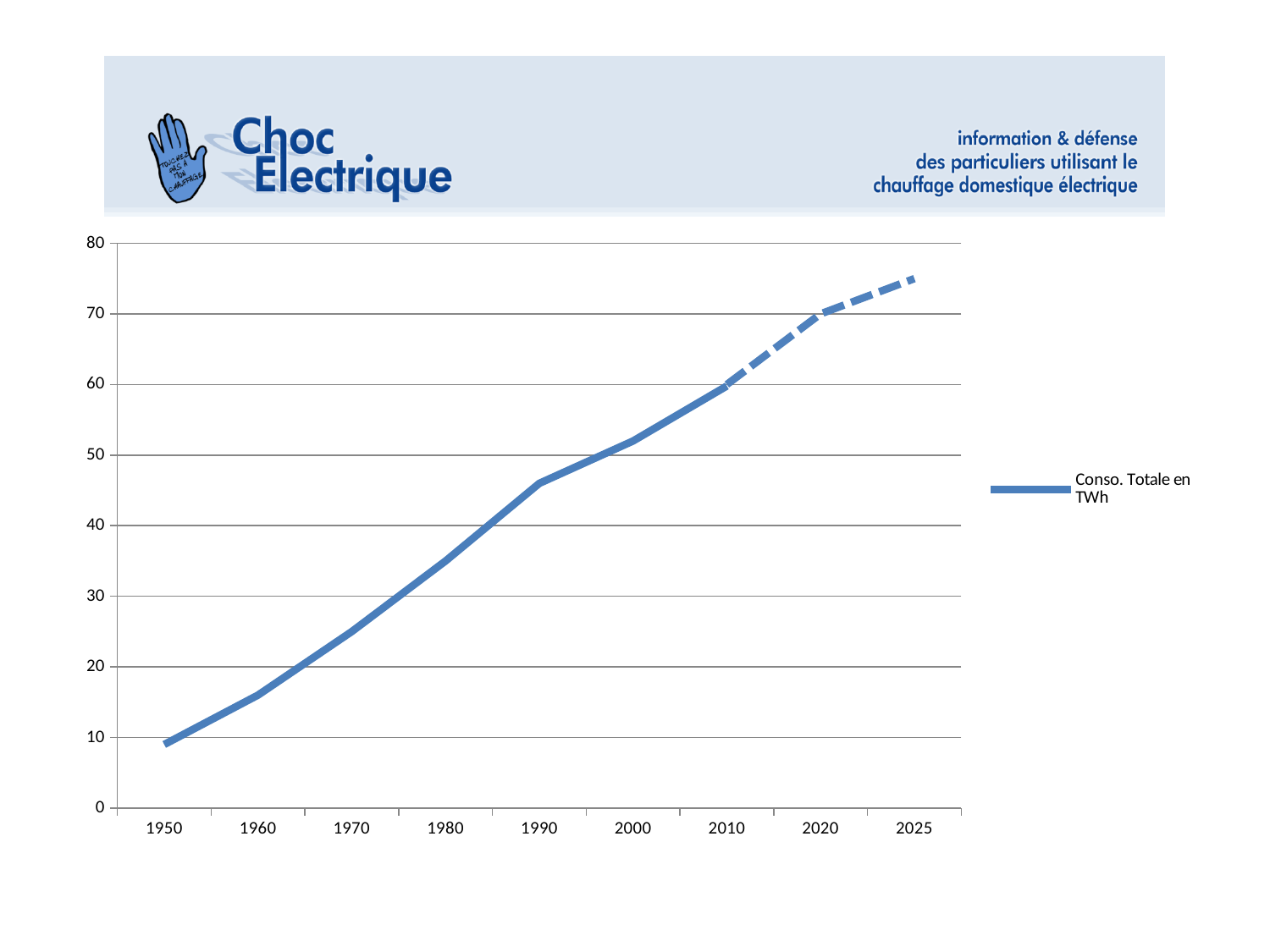
Do the values rise or fall from 1950 to 2025? rise What kind of chart is shown on the slide? line chart Is the value for 1970 greater or less than 30? less Is the value for 1960 greater or less than 20? less Which is larger, the value for 1980 or the value for 2000? 2000 What is the name of the series shown in the legend? Conso. Totale en TWh How many series does the legend list? 1 Which year has the highest value? 2025 Which year has the lowest value? 1950 Is the value for 1990 greater or less than 40? greater How many years are labelled on the x axis? 9